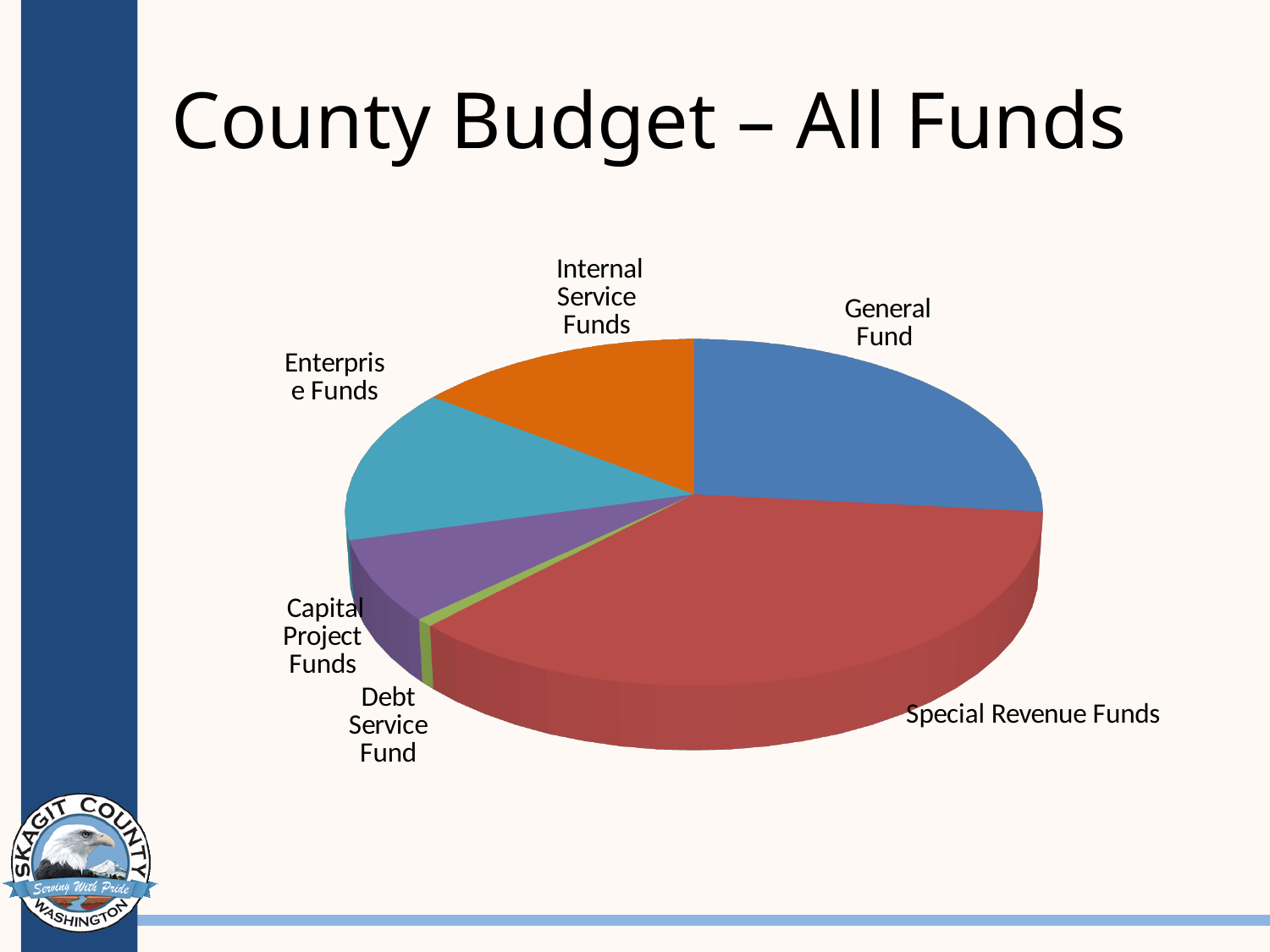
What is the title of the slide containing the pie chart? County Budget – All Funds Which slice is larger, Internal Service Funds or Capital Project Funds? Internal Service Funds Which fund category has the largest slice of the pie chart? Special Revenue Funds How many slices does the pie chart have? 6 Which slice is larger, General Fund or Enterprise Funds? General Fund Which fund category has the smallest slice of the pie chart? Debt Service Fund What kind of chart is shown on the slide? pie chart Which slice is larger, Capital Project Funds or Debt Service Fund? Capital Project Funds What colour is the Special Revenue Funds slice? red